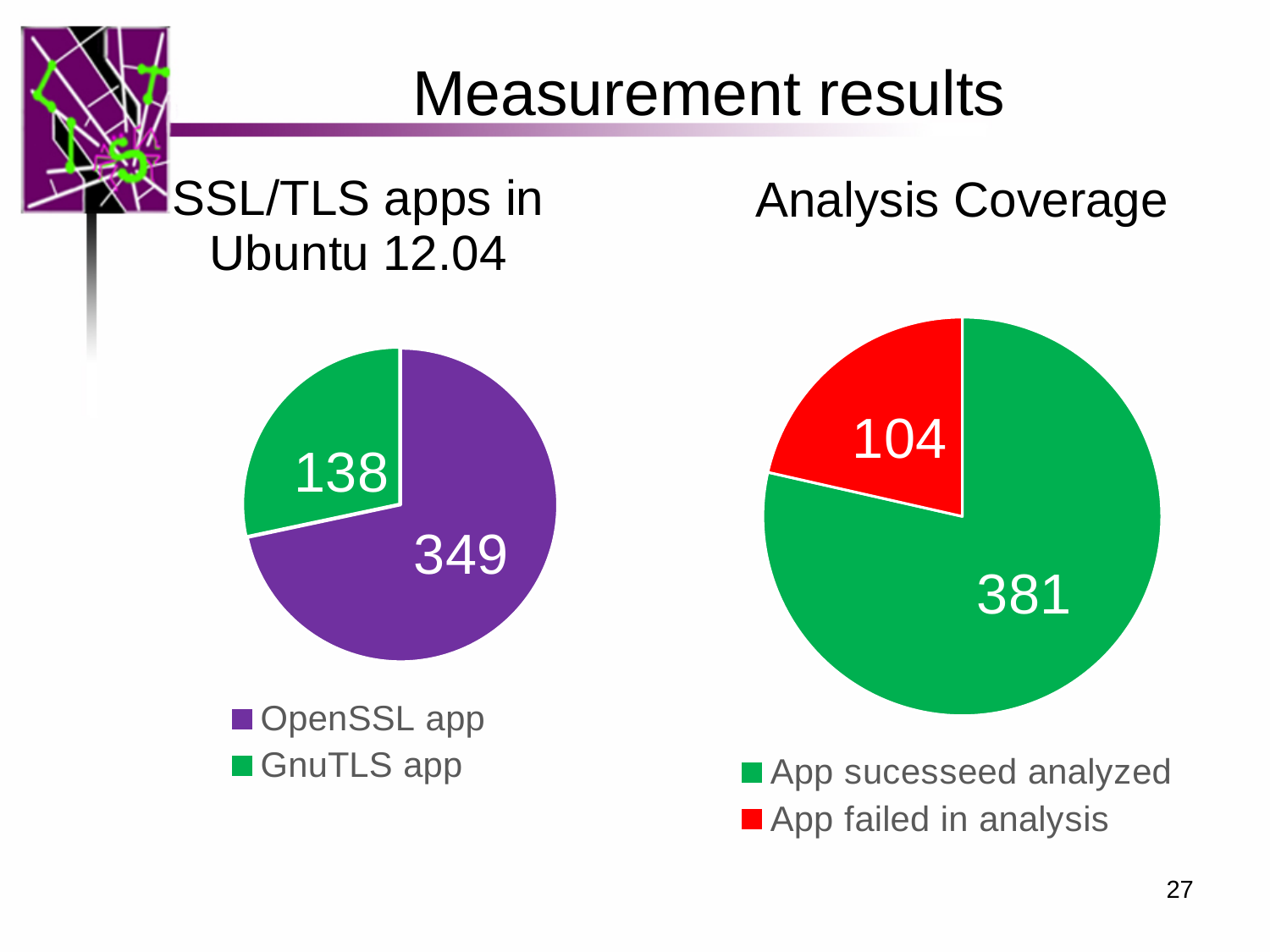
In the 'SSL/TLS apps in Ubuntu 12.04' chart, how many slices does the pie have? 2 In the 'SSL/TLS apps in Ubuntu 12.04' chart, what is the difference between the OpenSSL app and GnuTLS app values? 211 In the 'SSL/TLS apps in Ubuntu 12.04' chart, what is the value for OpenSSL app? 349 In the 'Analysis Coverage' chart, what is the value for App sucesseed analyzed? 381 In the 'Analysis Coverage' chart, what is the difference between the number of apps successfully analyzed and the number that failed? 277 In the 'Analysis Coverage' chart, what is the total of the two slices? 485 In the 'SSL/TLS apps in Ubuntu 12.04' chart, what is the value for GnuTLS app? 138 In the 'Analysis Coverage' chart, what is the value for App failed in analysis? 104 In the 'Analysis Coverage' chart, which category has the smallest slice? App failed in analysis In the 'SSL/TLS apps in Ubuntu 12.04' chart, which category has the largest slice? OpenSSL app In the 'Analysis Coverage' chart, what colour is the slice for App failed in analysis? Red What type of chart is the 'Analysis Coverage' chart? Pie chart